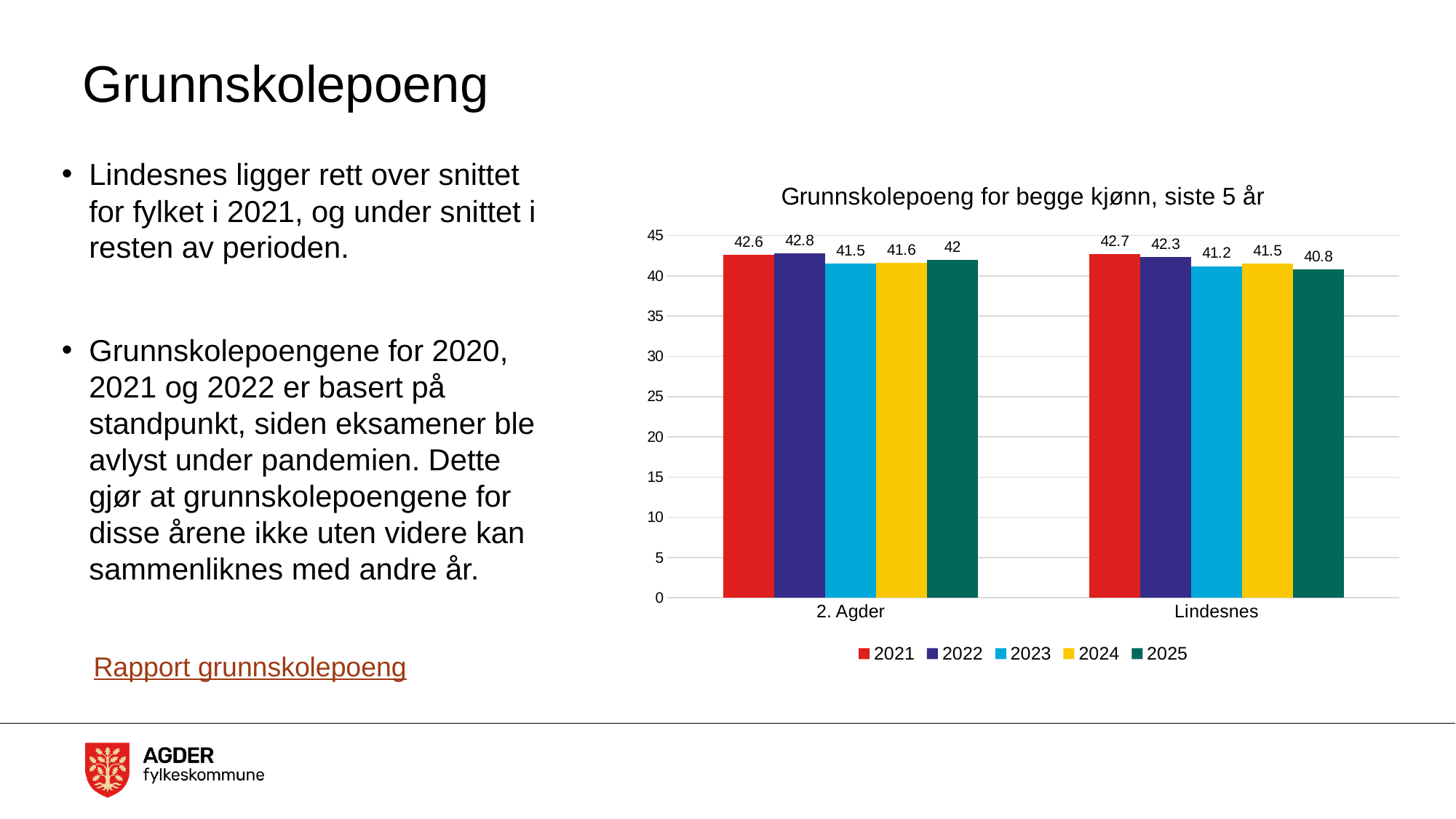
What is the value for 2. Agder in 2025? 42 Which is larger in 2022: the value for 2. Agder or for Lindesnes? 2. Agder How many series does the legend list? 5 How many categories are shown on the x axis? 2 What is the value for 2. Agder in 2021? 42.6 What is the title of the chart? Grunnskolepoeng for begge kjønn, siste 5 år What kind of chart is shown on the slide? Bar chart What is the difference between the 2. Agder and Lindesnes values in 2025? 1.2 Which year has the highest value for 2. Agder? 2022 Which year has the lowest value for Lindesnes? 2025 What is the value for Lindesnes in 2023? 41.2 What is the value for Lindesnes in 2025? 40.8